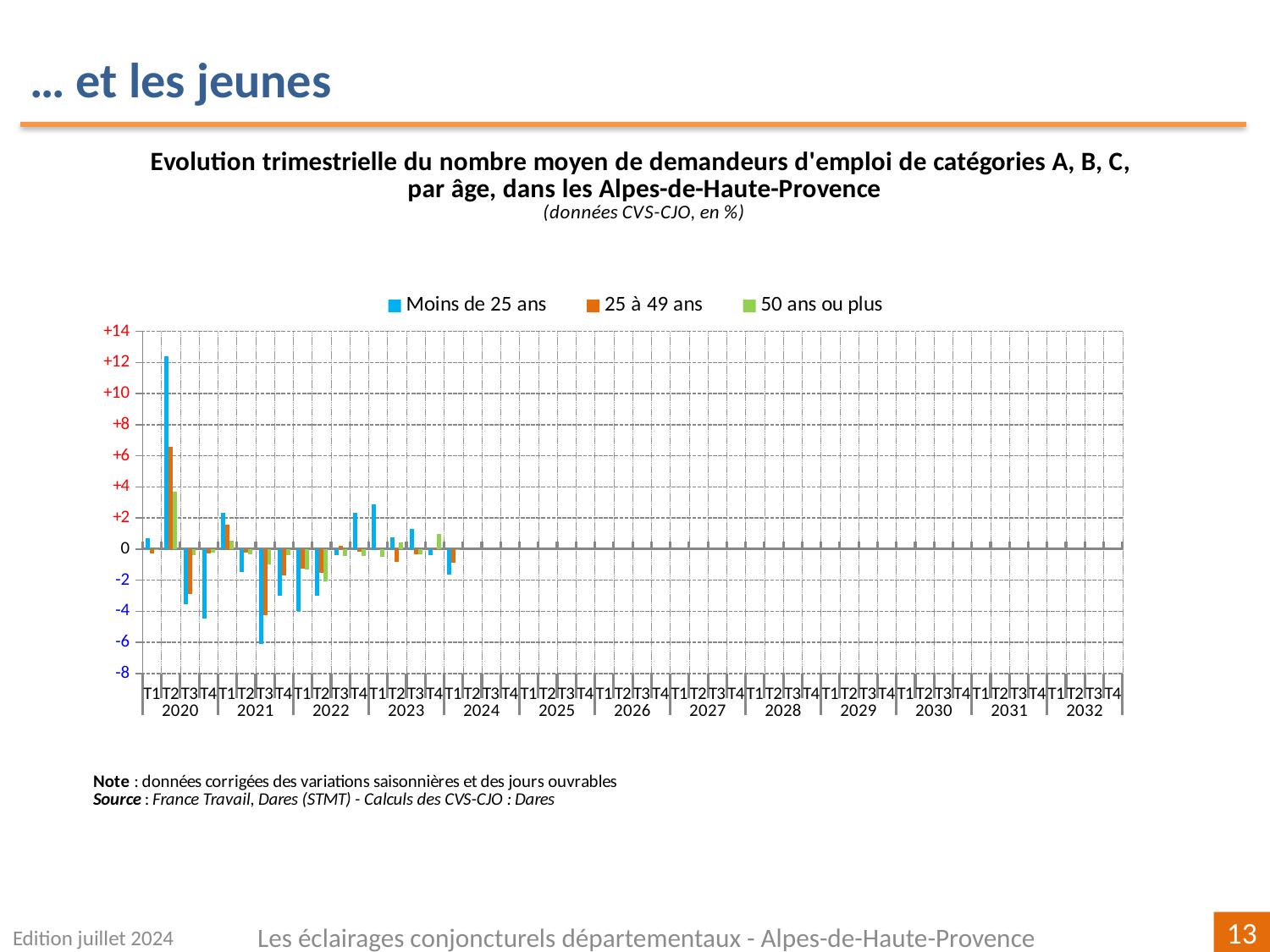
Is the value for '25 à 49 ans' in T2 2020 greater or less than +4? greater Is the value for 'Moins de 25 ans' in T4 2020 greater or less than -2? less Is the value for 'Moins de 25 ans' in T2 2020 greater or less than +10? greater In which quarter does the 'Moins de 25 ans' series reach its lowest value? T3 2021 What is the last year label shown on the x axis? 2032 In which quarter does the 'Moins de 25 ans' series reach its highest value? T2 2020 Which series is shown in blue in the legend? Moins de 25 ans How many year groups are labelled along the x axis? 13 How many series does the legend list? 3 What kind of chart is shown on the slide? bar chart In T2 2020, which series has the larger value, 'Moins de 25 ans' or '25 à 49 ans'? Moins de 25 ans